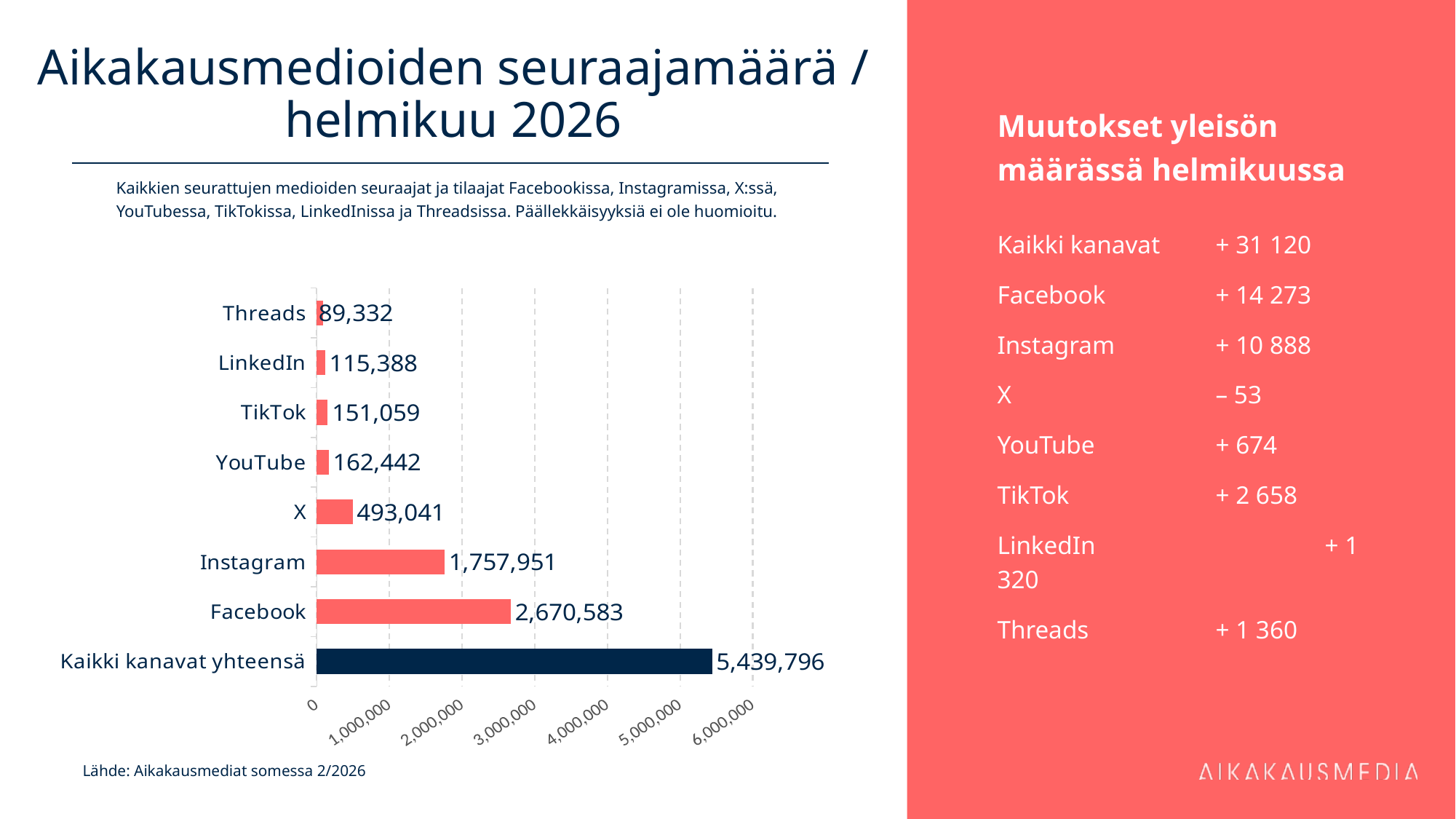
What is the difference between the Facebook and Instagram values in the bar chart? 912,632 What kind of chart is shown on the slide? bar chart What is the value shown for Instagram in the bar chart? 1,757,951 What is the value shown for 'Kaikki kanavat yhteensä' in the bar chart? 5,439,796 What is the value shown for Threads in the bar chart? 89,332 How many categories (bars) are shown in the bar chart? 8 Is the value for X in the bar chart greater or less than 1,000,000? less What is the difference between the YouTube and TikTok values in the bar chart? 11,383 Which is larger in the bar chart, the value for X or the value for YouTube? X Which category has the lowest value in the bar chart? Threads Which individual platform (excluding the total bar) has the highest value in the bar chart? Facebook What is the value shown for Facebook in the bar chart? 2,670,583